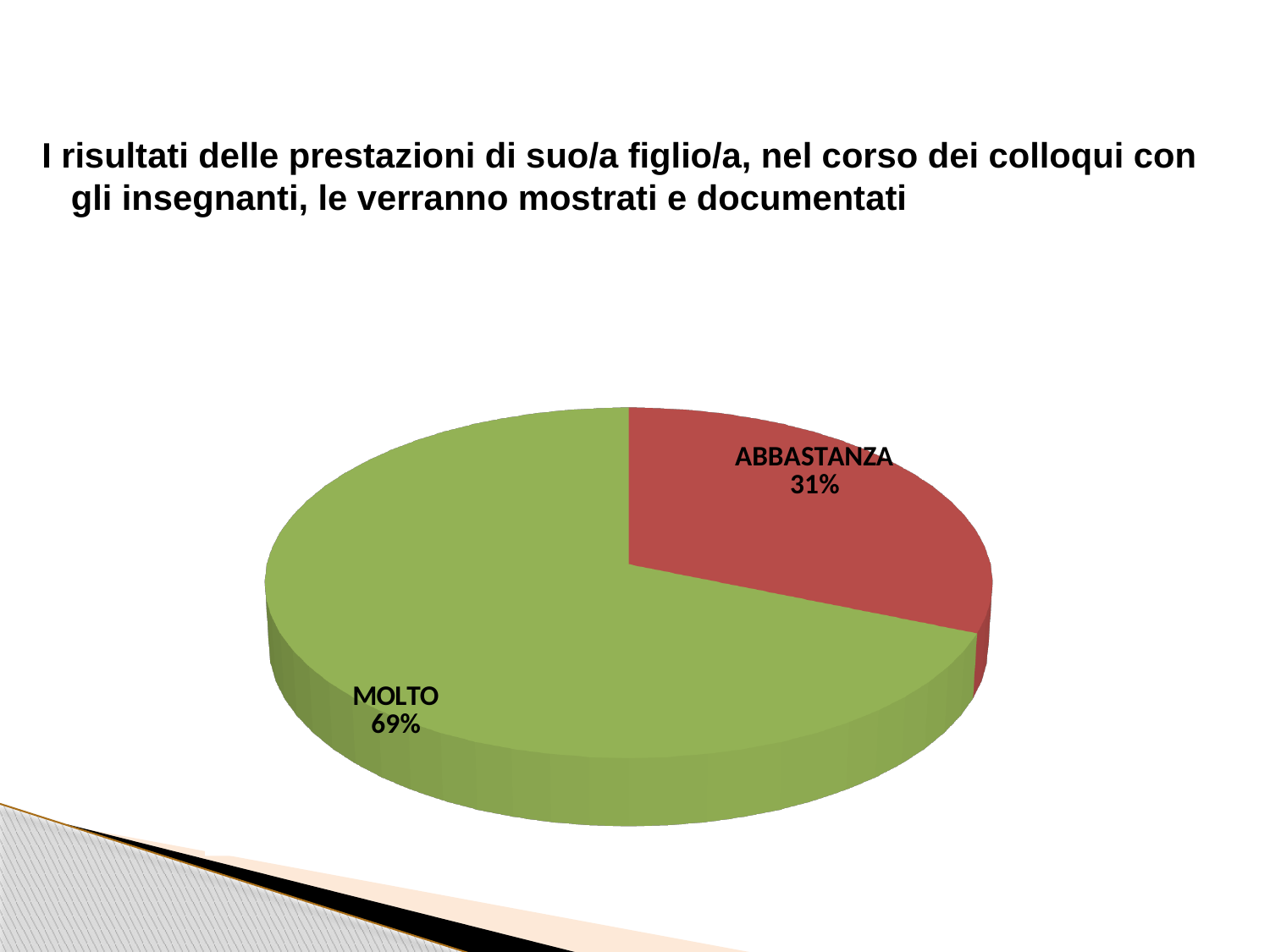
Which slice is larger, MOLTO or ABBASTANZA? MOLTO Which category has the smallest share of the pie? ABBASTANZA What share of the pie is taken by the ABBASTANZA slice? 31% What colour is the ABBASTANZA slice? Red How many slices does the pie chart have? 2 What colour is the MOLTO slice? Green What is the difference in percentage points between the MOLTO and ABBASTANZA slices? 38 Which category has the largest share of the pie? MOLTO What kind of chart is shown on the slide? Pie chart What percentage of the pie does the MOLTO slice represent? 69% What percentage of the pie does the ABBASTANZA slice represent? 31%